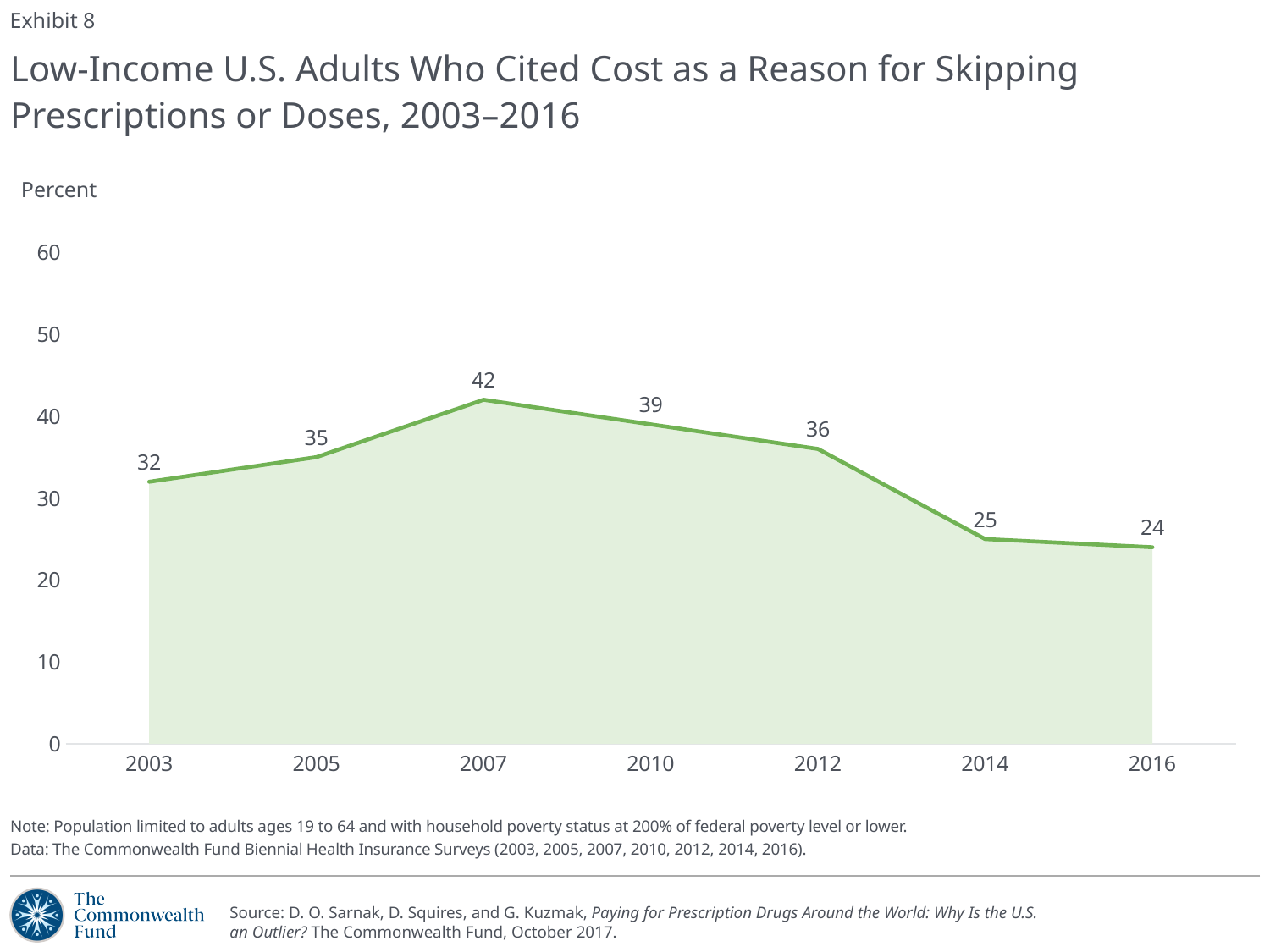
What percentage of low-income U.S. adults cited cost as a reason for skipping prescriptions or doses in 2007? 42 What is the difference between the 2007 value and the 2016 value? 18 Do the values rise or fall from 2007 to 2016? Fall What is the difference between the 2012 value and the 2014 value? 11 In which year was the percentage lowest? 2016 What is the value shown for 2016? 24 In which year was the percentage highest? 2007 Is the value for 2012 greater or less than 30? greater What kind of chart is shown on the slide? Area chart Which year has a higher value, 2005 or 2010? 2010 What is the value shown for 2003? 32 How many years are plotted on the chart? 7